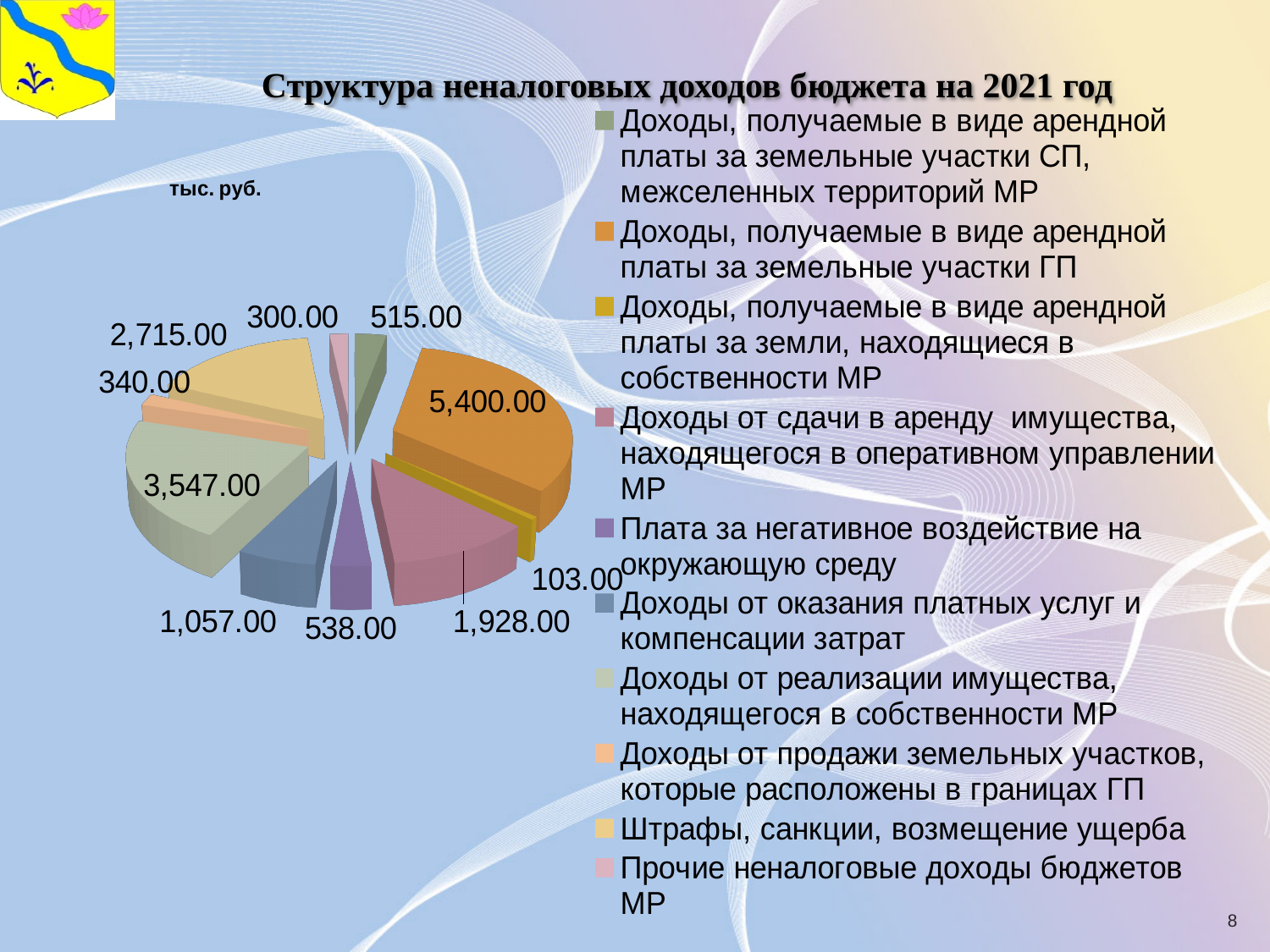
How many slices does the pie chart have? 10 What kind of chart is shown on the slide? pie chart What is the difference between the value for 'Доходы, получаемые в виде арендной платы за земельные участки ГП' and the value for 'Доходы от реализации имущества, находящегося в собственности МР'? 1,853.00 What is the value for 'Плата за негативное воздействие на окружающую среду'? 538.00 Which category has the largest slice of the pie? Доходы, получаемые в виде арендной платы за земельные участки ГП What is the value for 'Доходы от реализации имущества, находящегося в собственности МР'? 3,547.00 In what units are the values on the chart given? тыс. руб. What is the value for 'Штрафы, санкции, возмещение ущерба'? 2,715.00 Which category has the smallest slice of the pie? Доходы, получаемые в виде арендной платы за земли, находящиеся в собственности МР Which is larger: 'Доходы от оказания платных услуг и компенсации затрат' or 'Доходы от сдачи в аренду имущества, находящегося в оперативном управлении МР'? Доходы от сдачи в аренду имущества, находящегося в оперативном управлении МР What is the value for 'Доходы, получаемые в виде арендной платы за земельные участки ГП'? 5,400.00 What is the title of the chart on the slide? Структура неналоговых доходов бюджета на 2021 год